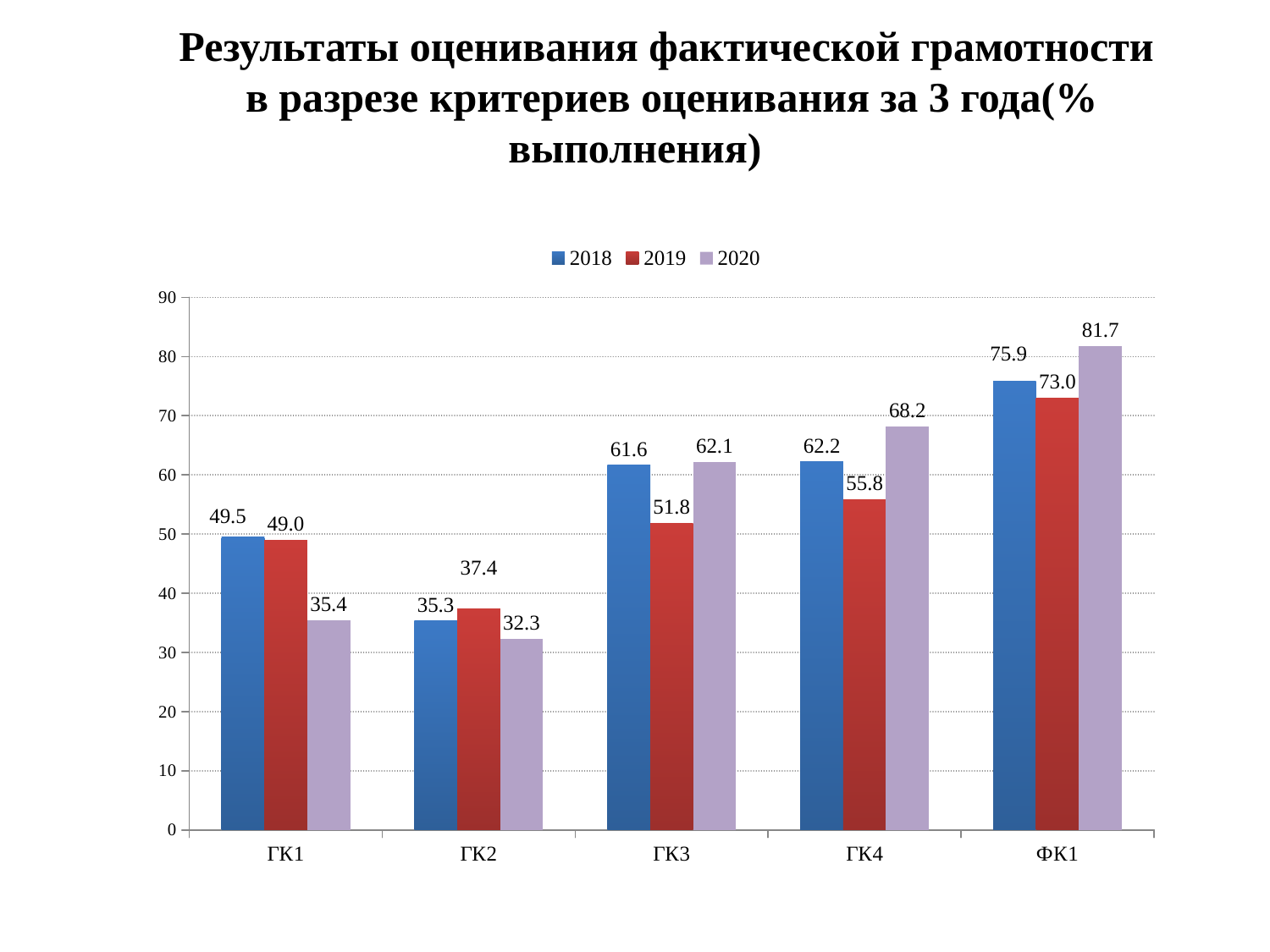
How many categories are shown on the x axis? 5 What is the difference between the 2018 and 2020 values for ГК1? 14.1 What is the value for ГК3 in 2019? 51.8 Which is larger for ГК2: the 2018 value or the 2019 value? 2019 What is the value for ФК1 in 2020? 81.7 Which category has the highest value in 2018? ФК1 Which category has the lowest value in 2020? ГК2 Which series is shown in purple in the legend? 2020 What is the value for ГК1 in 2020? 35.4 What kind of chart is shown on the slide? bar chart How many series does the legend list? 3 What is the difference between the 2020 and 2018 values for ГК4? 6.0